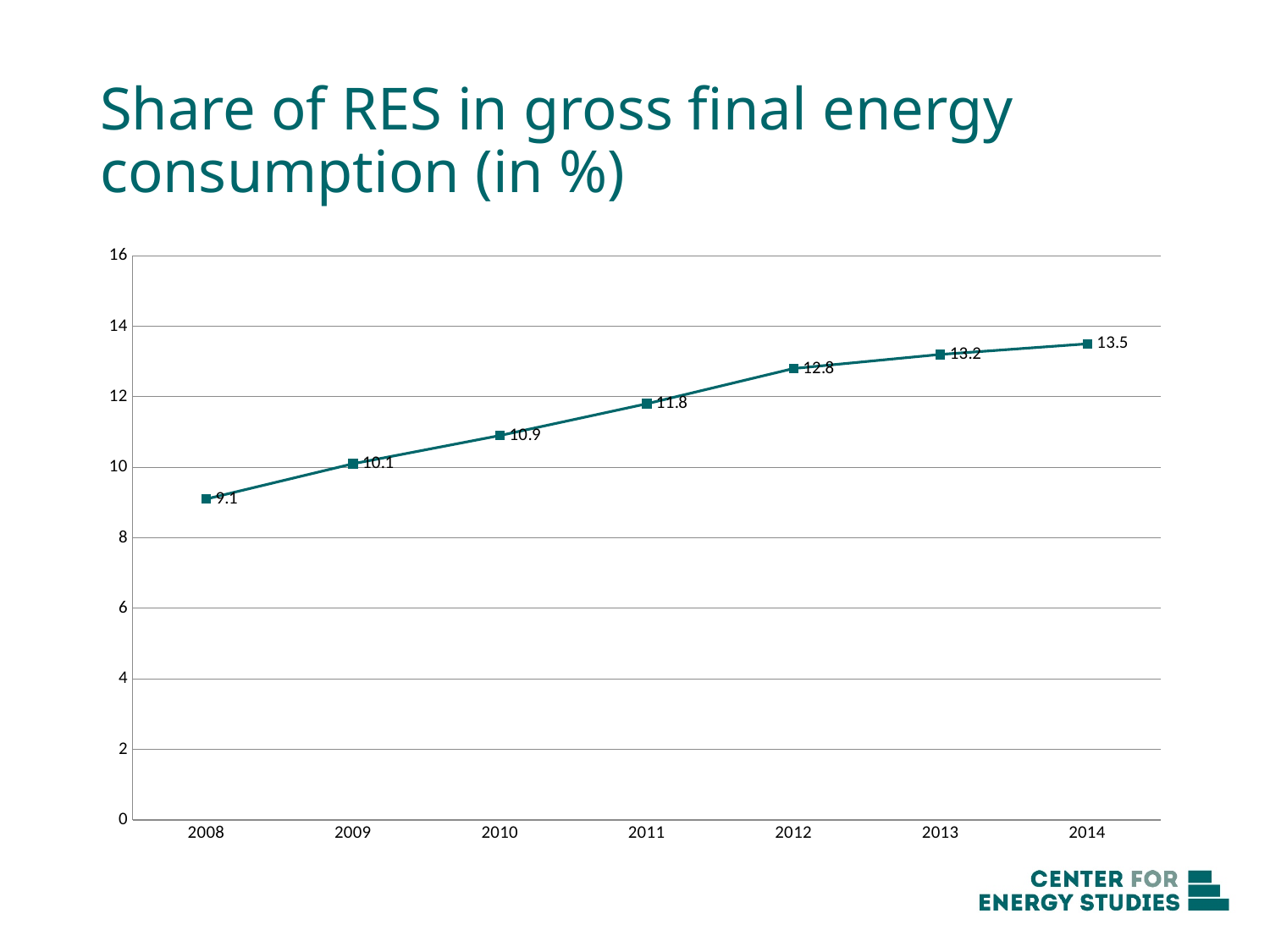
What is the value shown for 2014? 13.5 What is the difference between the values for 2012 and 2011? 1.0 Is the value for 2012 greater or less than 12? greater Which year has the lowest share of RES? 2008 How many years are plotted on the chart? 7 What is the value shown for 2011? 11.8 Do the values rise or fall from 2008 to 2014? rise Which year has the highest share of RES? 2014 By how much did the share of RES increase from 2008 to 2014? 4.4 What is the share of RES in gross final energy consumption in 2008? 9.1 Which year has a larger value, 2010 or 2013? 2013 What kind of chart is shown on the slide? line chart